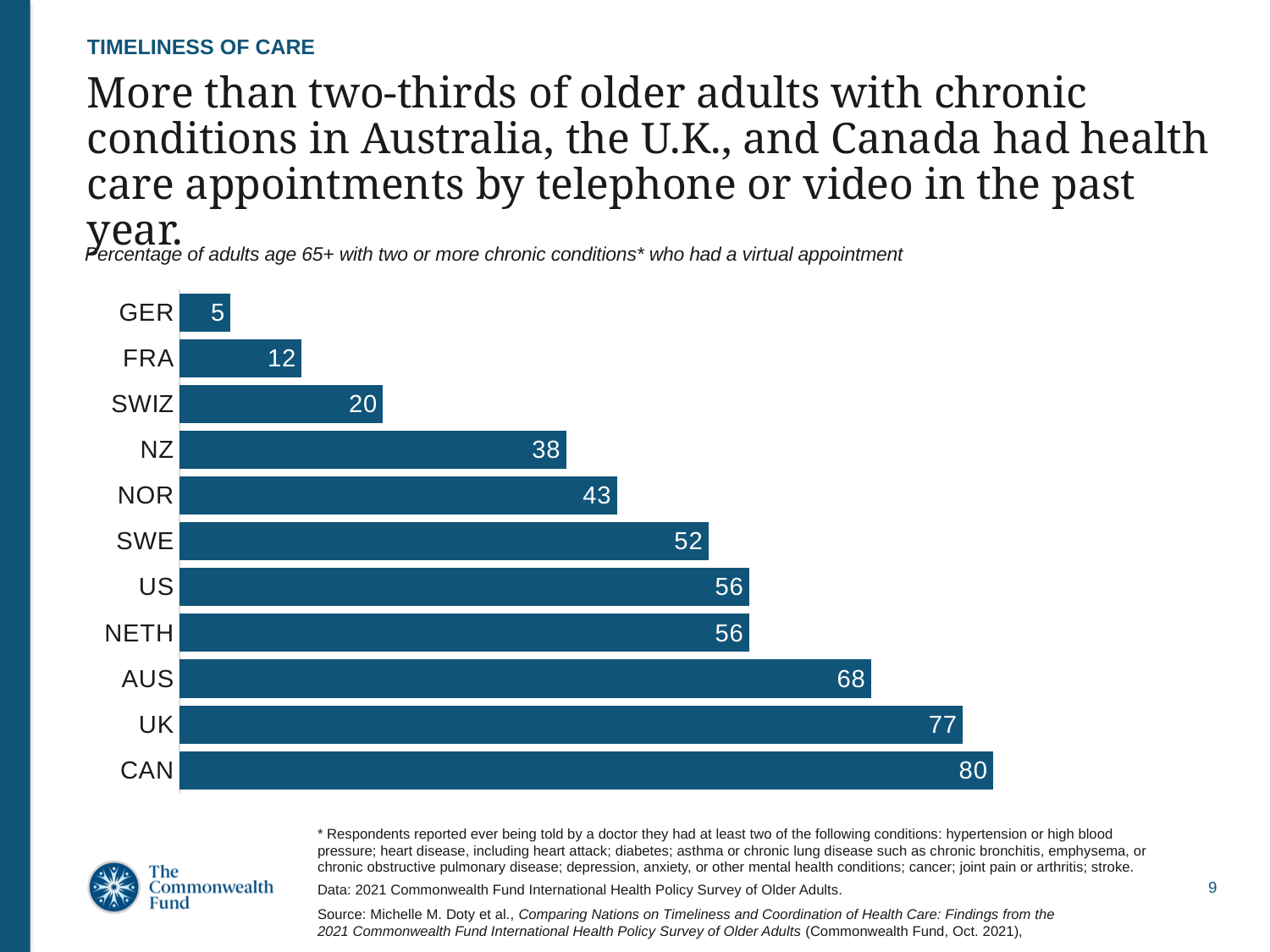
Which country has the highest value? CAN What is the subtitle describing what the chart measures? Percentage of adults age 65+ with two or more chronic conditions* who had a virtual appointment What kind of chart is shown on the slide? bar chart Which country has the lowest value? GER What is the value for GER? 5 What is the difference between the values for CAN and GER? 75 What is the value for NOR? 43 Which is larger, the value for SWE or the value for NZ? SWE What is the value for CAN? 80 What is the value for NETH? 56 How many countries are shown in the chart? 11 What is the difference between the values for UK and AUS? 9